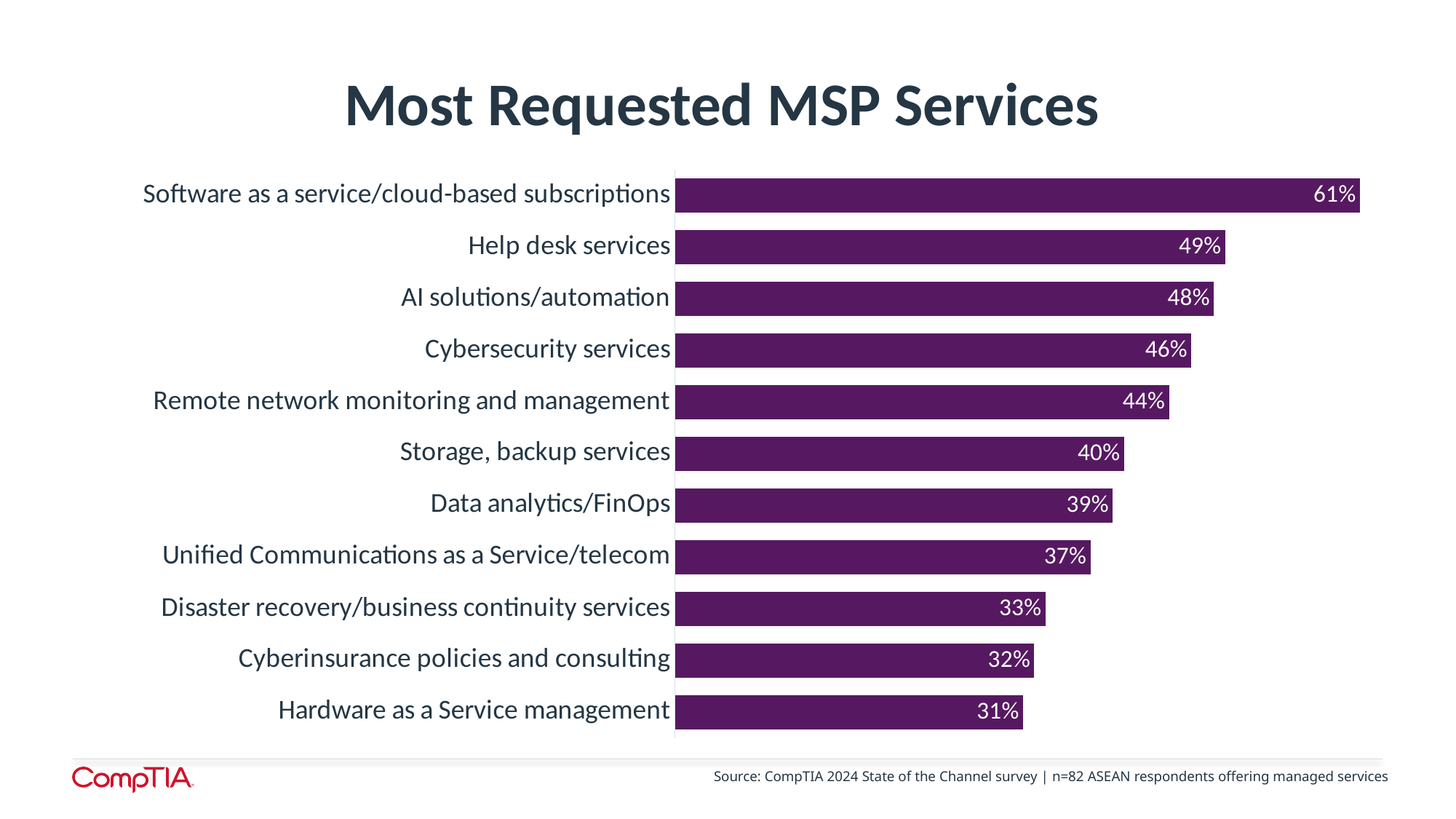
Which is larger: Disaster recovery/business continuity services or Unified Communications as a Service/telecom? Unified Communications as a Service/telecom What percentage is shown for Storage, backup services? 40% How many services are shown in the chart? 11 What is the title of the chart? Most Requested MSP Services What is the value for Cybersecurity services? 46% Which is larger: AI solutions/automation or Cybersecurity services? AI solutions/automation What kind of chart is shown on the slide? Bar chart What is the difference between Remote network monitoring and management and Data analytics/FinOps? 5% What percentage is shown for Help desk services? 49% Which service has the highest value? Software as a service/cloud-based subscriptions What is the difference between Software as a service/cloud-based subscriptions and Help desk services? 12% Which service has the lowest value? Hardware as a Service management